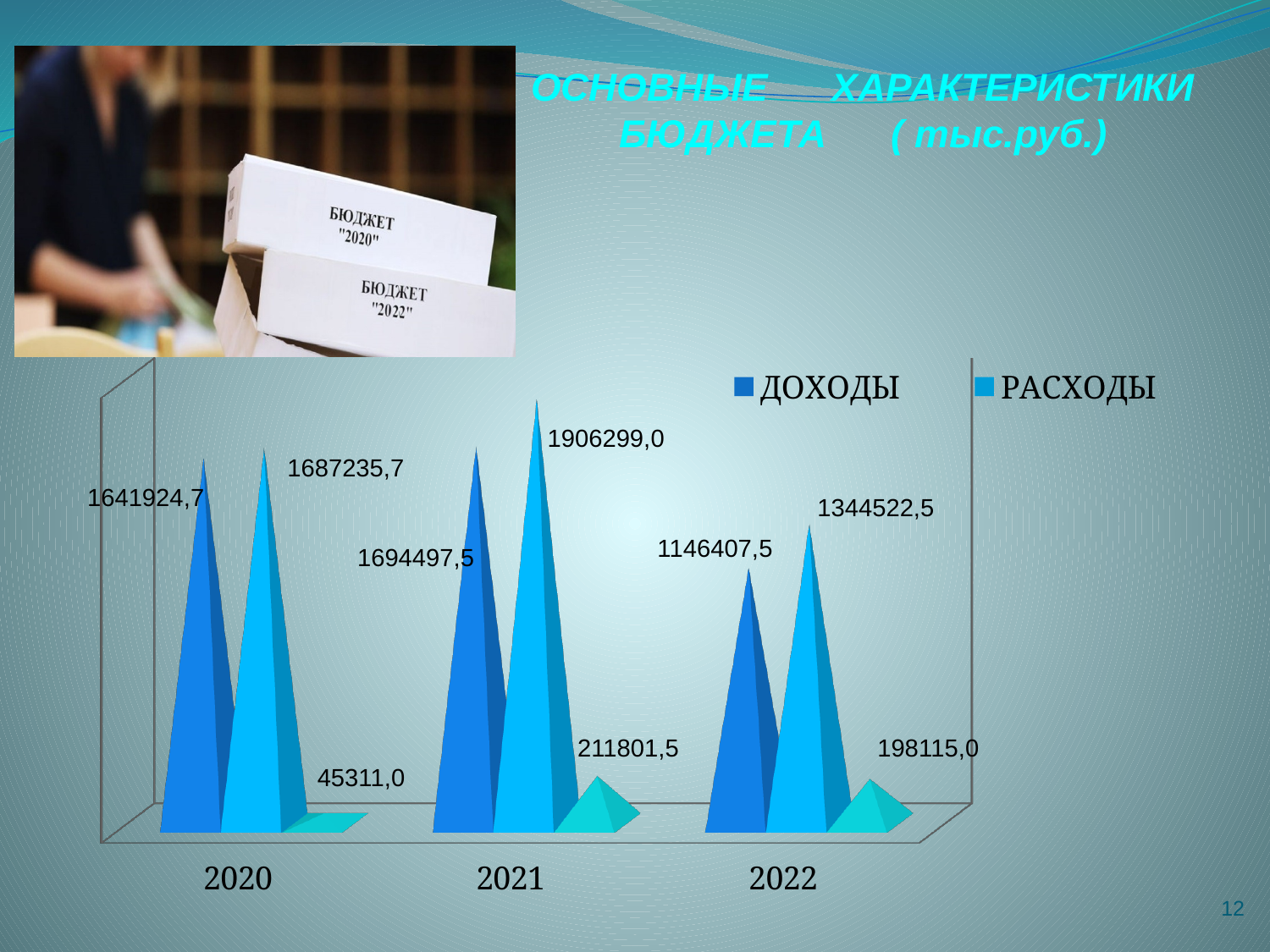
Which is larger in 2022, ДОХОДЫ or РАСХОДЫ? РАСХОДЫ What is the difference between РАСХОДЫ and ДОХОДЫ in 2020? 45311,0 What is the value of ДОХОДЫ for 2022? 1146407,5 In which year is РАСХОДЫ lowest? 2022 How many years are shown on the x axis of the chart? 3 What is the difference between РАСХОДЫ and ДОХОДЫ in 2021? 211801,5 What is the value of ДОХОДЫ for 2020? 1641924,7 How many series does the chart legend list? 2 In which year is ДОХОДЫ highest? 2021 What is the value of РАСХОДЫ for 2022? 1344522,5 Does ДОХОДЫ rise or fall from 2021 to 2022? fall What is the value of РАСХОДЫ for 2021? 1906299,0